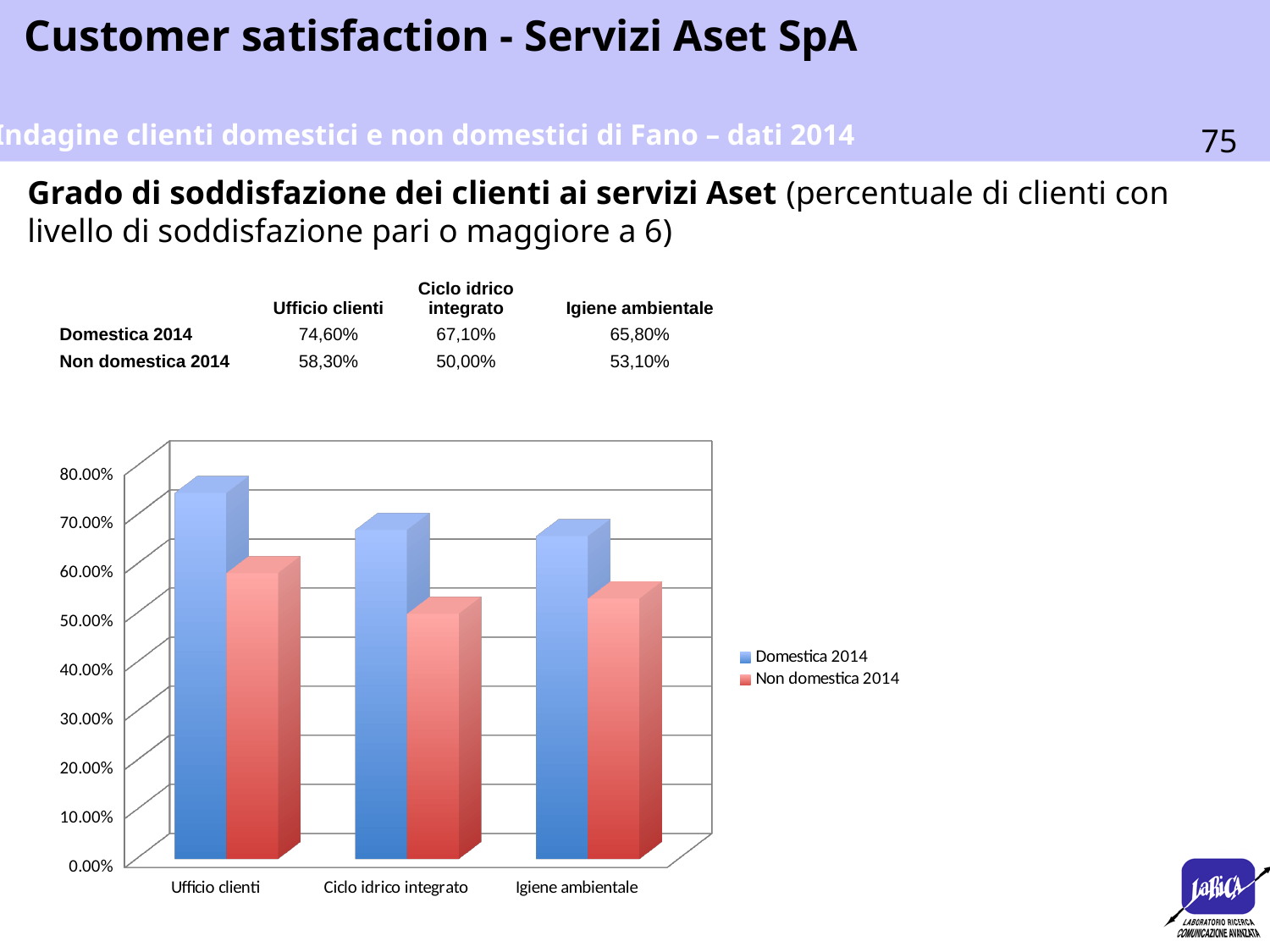
Which colour represents the Non domestica 2014 series in the chart? red Which category has the highest value for Domestica 2014? Ufficio clienti How many series does the chart legend list? 2 What type of chart is shown on the slide? bar chart What is the value for Non domestica 2014 in the Ciclo idrico integrato category? 50,00% Is the value for Non domestica 2014 in Igiene ambientale greater or less than 60.00%? less Which category has the lowest value for Non domestica 2014? Ciclo idrico integrato What is the difference between Domestica 2014 and Non domestica 2014 for Ufficio clienti? 16,30% How many categories are shown on the x axis of the chart? 3 What is the value for Domestica 2014 in the Ufficio clienti category? 74,60% Which is larger for Igiene ambientale: Domestica 2014 or Non domestica 2014? Domestica 2014 What is the value for Domestica 2014 in the Igiene ambientale category? 65,80%